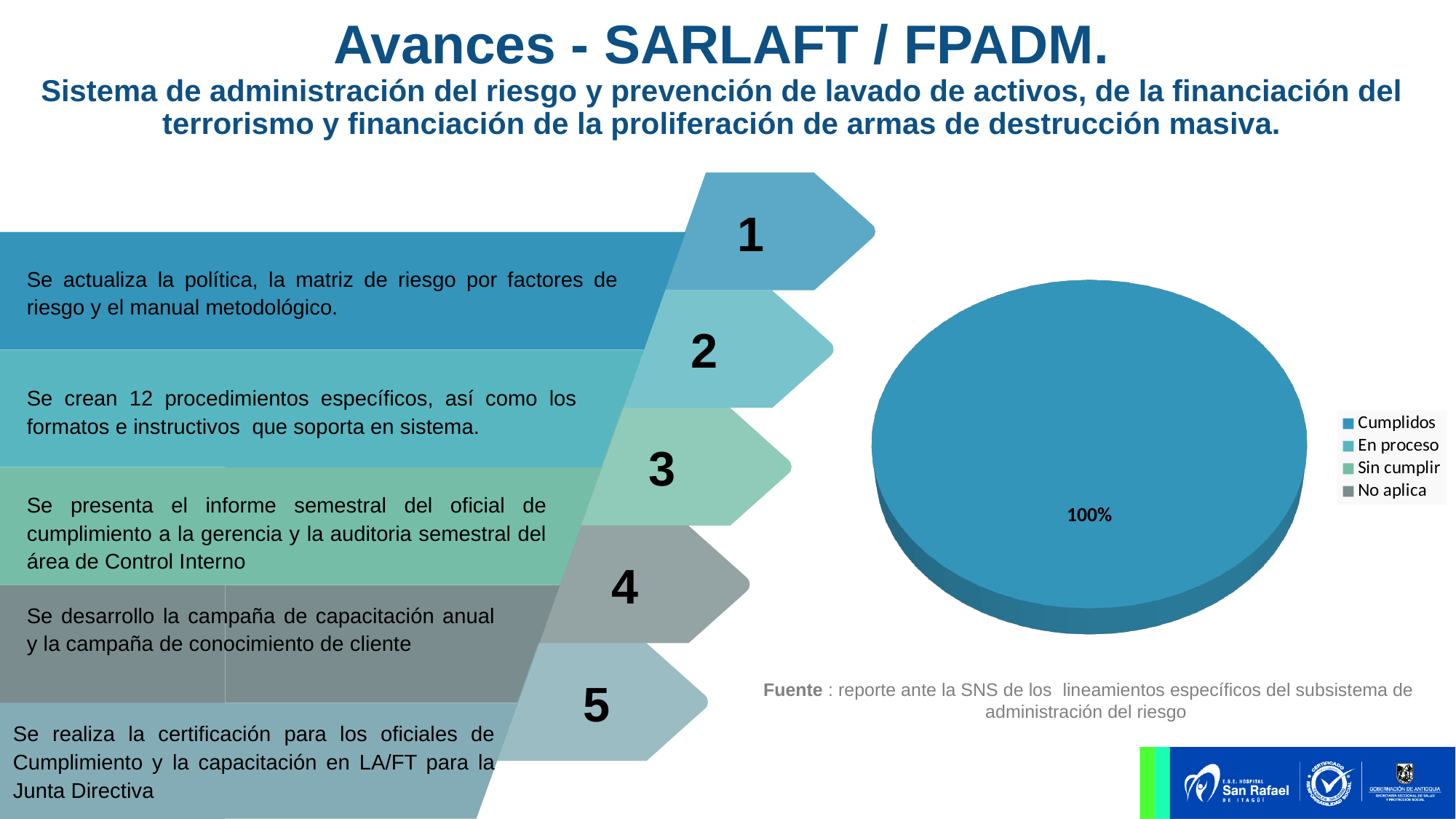
What kind of chart is shown on the right side of the slide? pie chart How many entries does the legend of the pie chart list? 4 Which legend entry is listed first in the pie chart's legend? Cumplidos What percentage is printed on the pie chart? 100% What share of the pie does the Cumplidos slice represent? 100% How many slices are visible in the pie chart? 1 Is the share for Cumplidos greater or less than 50%? greater Which legend entry is listed last in the pie chart's legend? No aplica Which category accounts for the largest share of the pie chart? Cumplidos